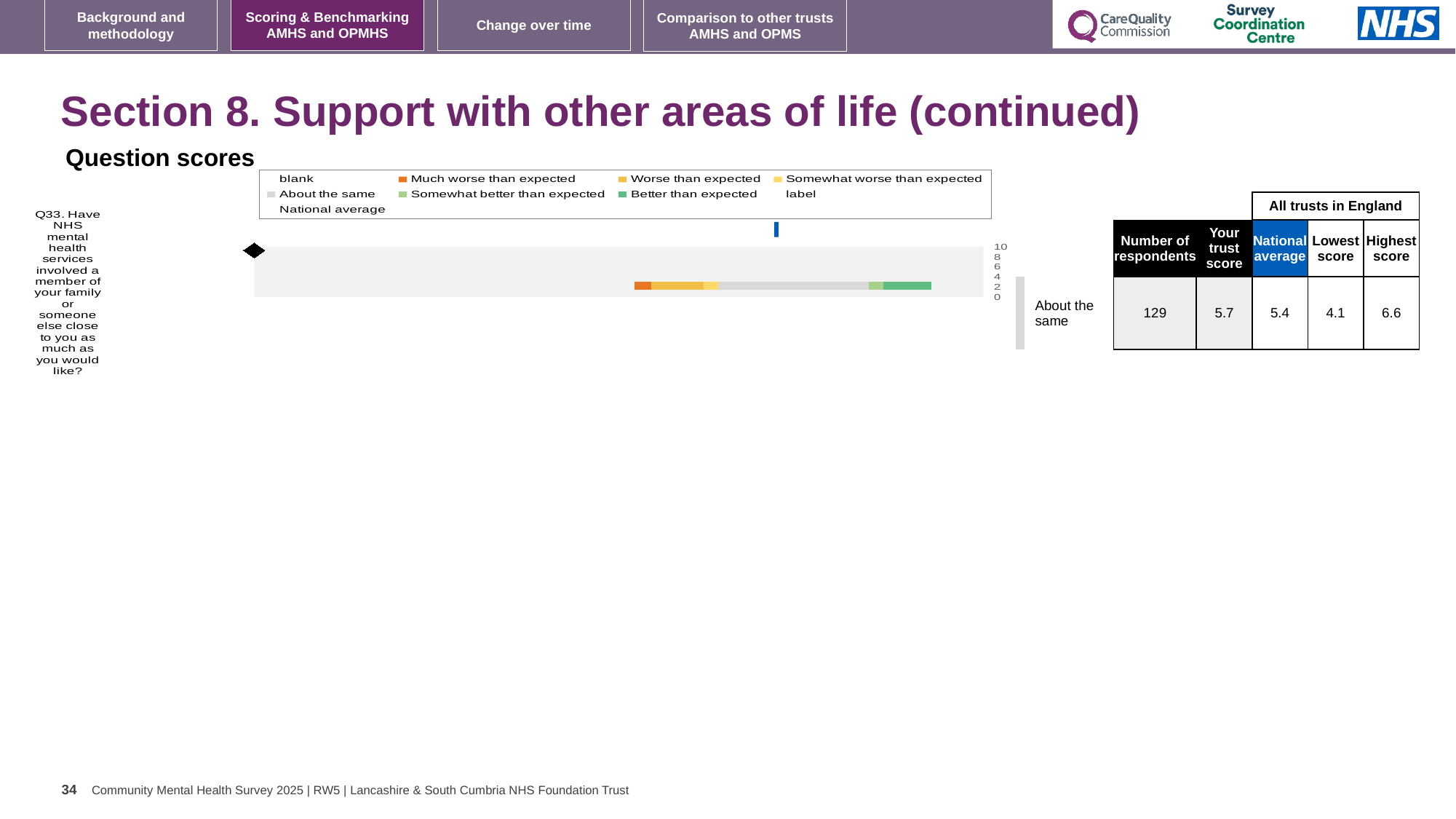
What is the trust's score for Q33 shown in the table beside the chart? 5.7 How many entries does the legend of the question scores chart list? 9 According to the table beside the chart, how many respondents answered Q33? 129 What is the highest score among all trusts in England for Q33? 6.6 What is the national average score for Q33 shown in the table beside the chart? 5.4 Which question number is plotted on the question scores chart? Q33 What is the lowest score among all trusts in England for Q33? 4.1 What is the difference between the highest and lowest trust scores for Q33? 2.5 For Q33, which is larger: the trust's score or the national average? the trust's score What colour is the 'Much worse than expected' band in the chart legend? orange What kind of chart is used to show the Q33 question score? bar chart How many questions are plotted on the question scores chart? 1